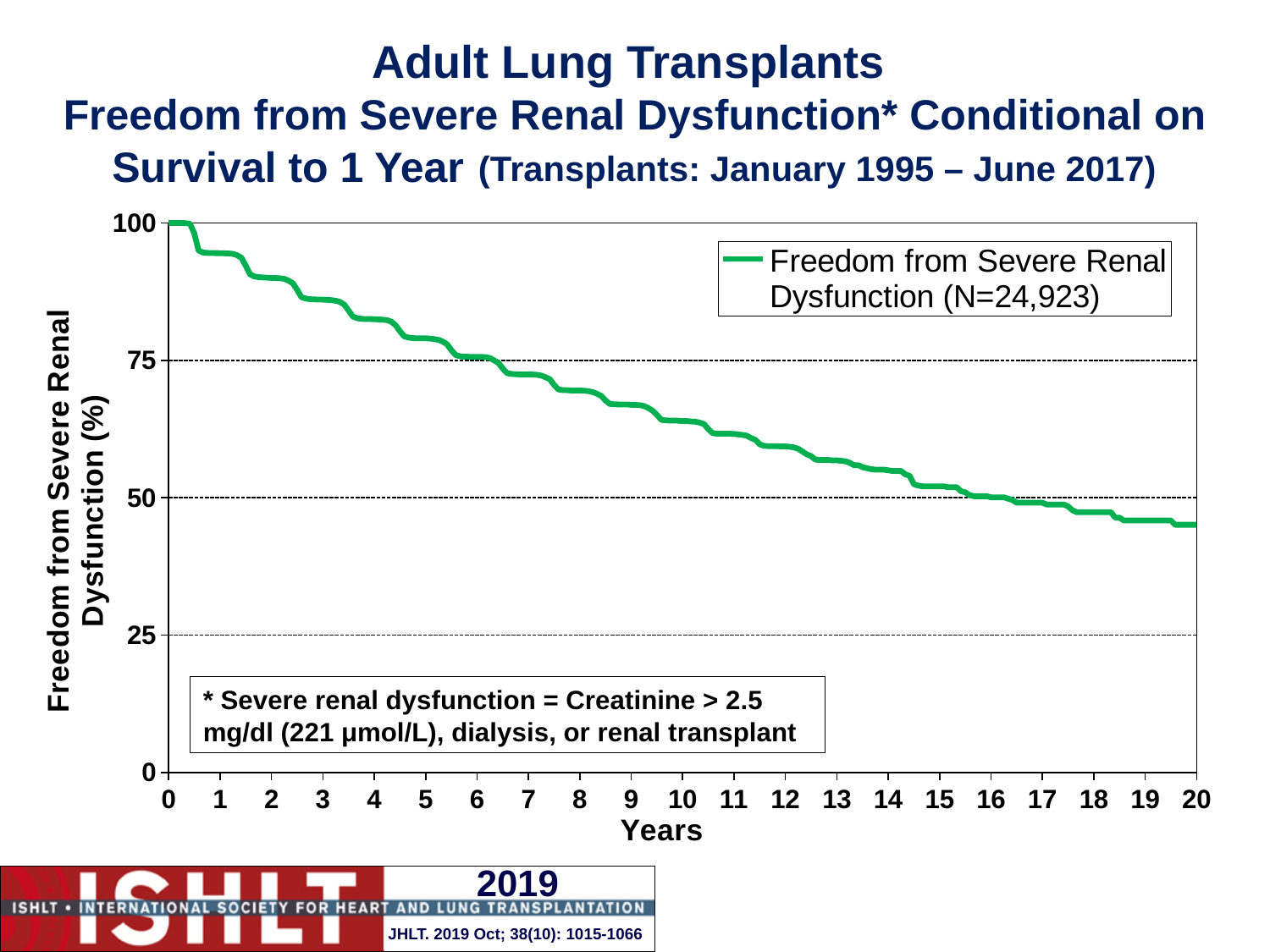
What is the label of the x axis? Years What kind of chart is shown on the slide? line chart Is the value for freedom from severe renal dysfunction at year 8 greater or less than 75? less Is the value for freedom from severe renal dysfunction at year 5 greater or less than 75? greater What is the number of patients (N) given in the legend entry? 24,923 How many series does the legend list? 1 Is the value for freedom from severe renal dysfunction at year 10 greater or less than 50? greater At which year on the x axis is freedom from severe renal dysfunction lowest? 20 What is the value of freedom from severe renal dysfunction at year 0? 100 Does the freedom from severe renal dysfunction rise or fall as years increase? fall Which is larger, the value at year 3 or the value at year 12? year 3